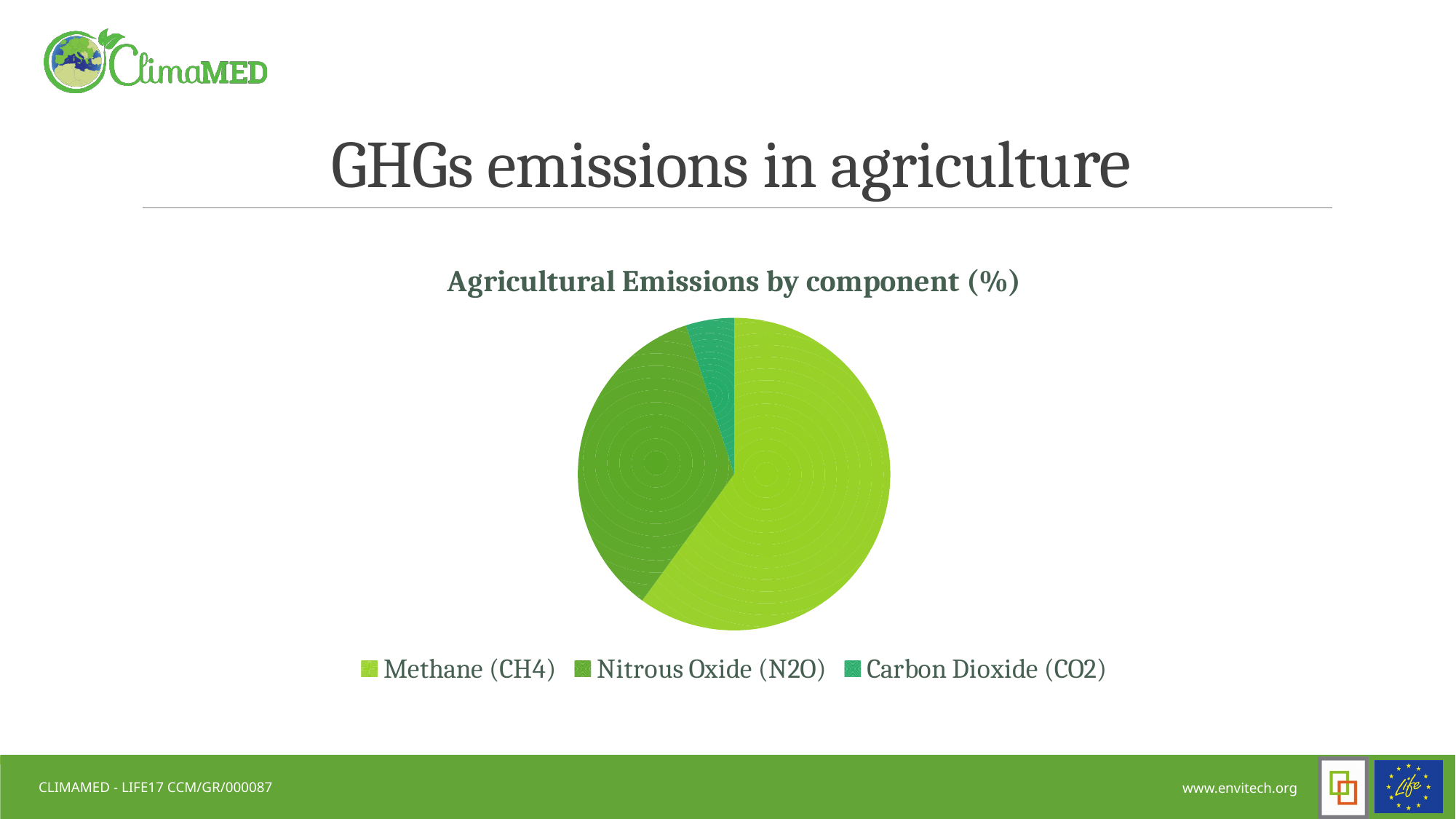
How many categories does the legend list? 3 Which component has the largest slice of the pie? Methane (CH4) What is the title of the chart? Agricultural Emissions by component (%) Which component has the smallest slice of the pie? Carbon Dioxide (CO2) Which slice is larger, Nitrous Oxide (N2O) or Carbon Dioxide (CO2)? Nitrous Oxide (N2O) Is the Methane (CH4) share of the pie greater or less than 50%? greater Is the Nitrous Oxide (N2O) share of the pie greater or less than 50%? less What kind of chart is shown on the slide? pie chart Which slice is larger, Methane (CH4) or Nitrous Oxide (N2O)? Methane (CH4) Which legend entry is shown in the lightest green colour? Methane (CH4) Is the Carbon Dioxide (CO2) share of the pie greater or less than 10%? less